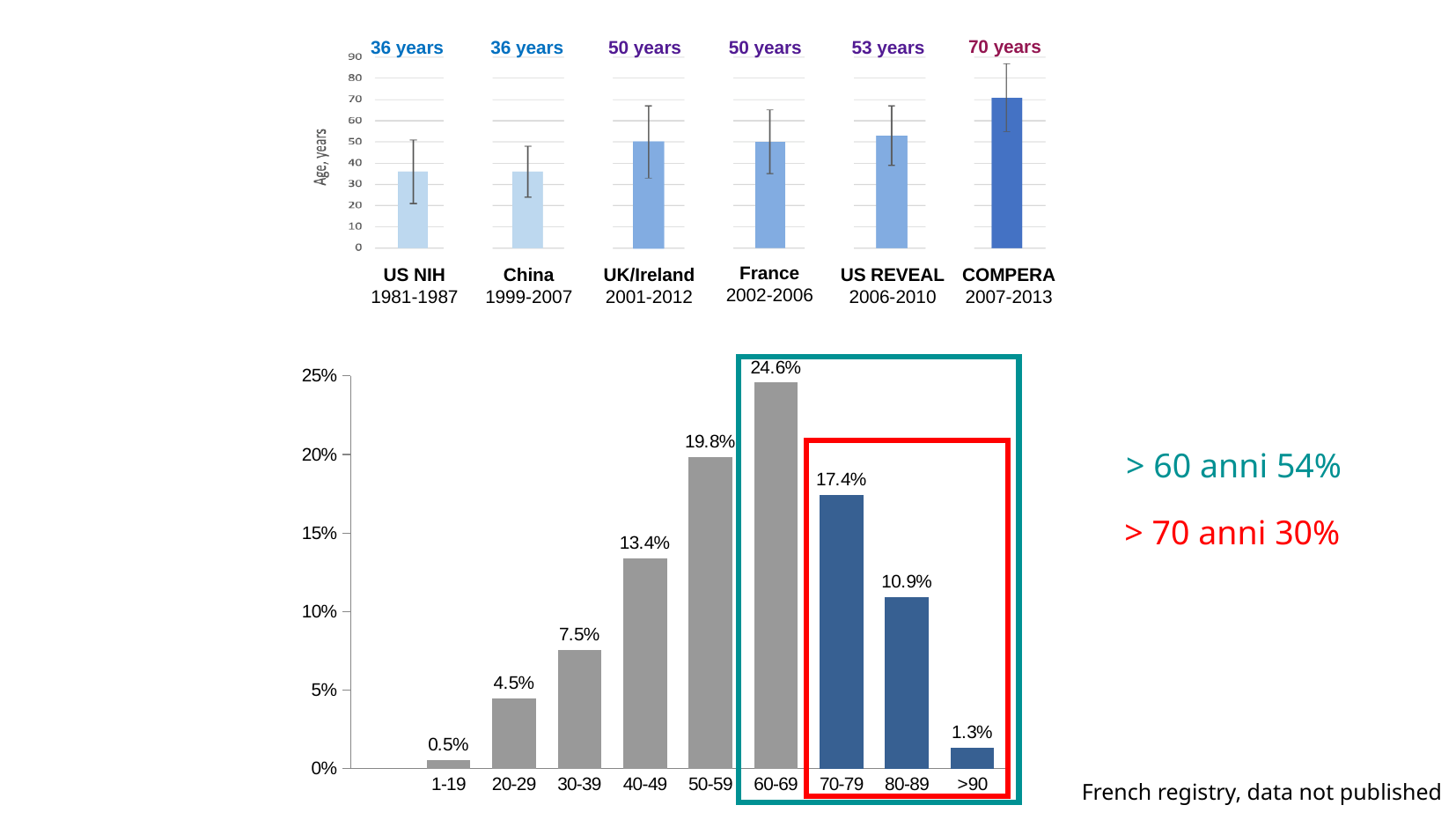
What kind of chart is the bottom chart? Bar chart In the top chart, which registry has the highest age value? COMPERA In the top chart, what is the difference between the values for US REVEAL and US NIH? 17 years In the top chart, what is the value for COMPERA? 70 years In the top chart, how many registries are shown? 6 In the bottom chart, how many age groups are shown on the x axis? 9 In the bottom chart, what is the value for the 60-69 age group? 24.6% In the bottom chart, which age group has the lowest value? 1-19 In the bottom chart, what is the difference between the values for 70-79 and 80-89? 6.5% In the bottom chart, which age group has the highest value? 60-69 In the bottom chart, which is larger, the value for 40-49 or the value for 80-89? 40-49 In the top chart, what is the value for US REVEAL? 53 years